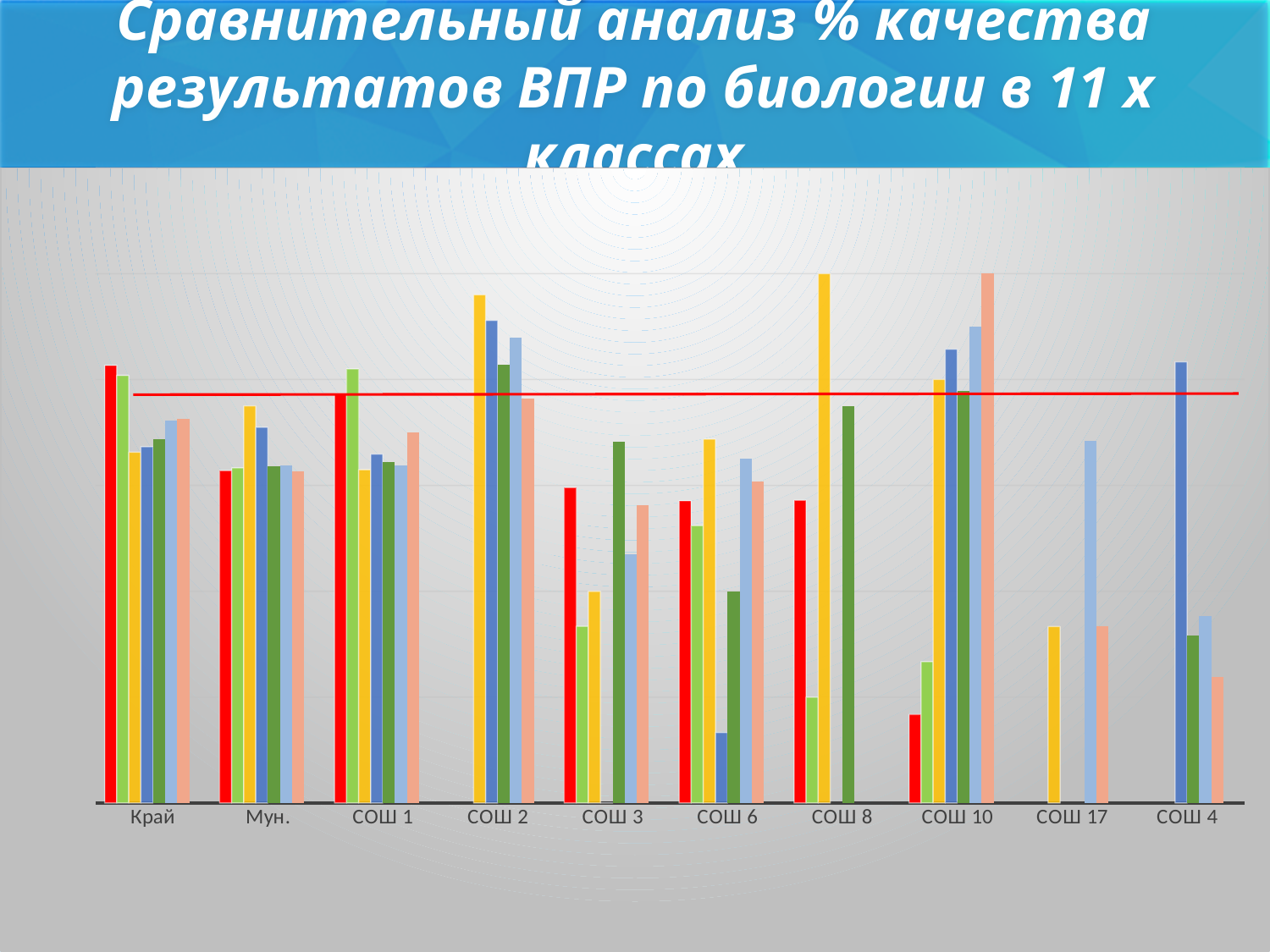
Which category on the x axis has the fewest bars plotted? СОШ 17 How many bars are plotted for the category СОШ 17? 3 What is the first category on the x axis of the chart? Край How many bars are plotted for the category СОШ 4? 4 What is the last category on the x axis of the chart? СОШ 4 How many categories are shown along the x axis of the chart? 10 Which category comes immediately after СОШ 3 on the x axis? СОШ 6 What kind of chart is shown on the slide? bar chart